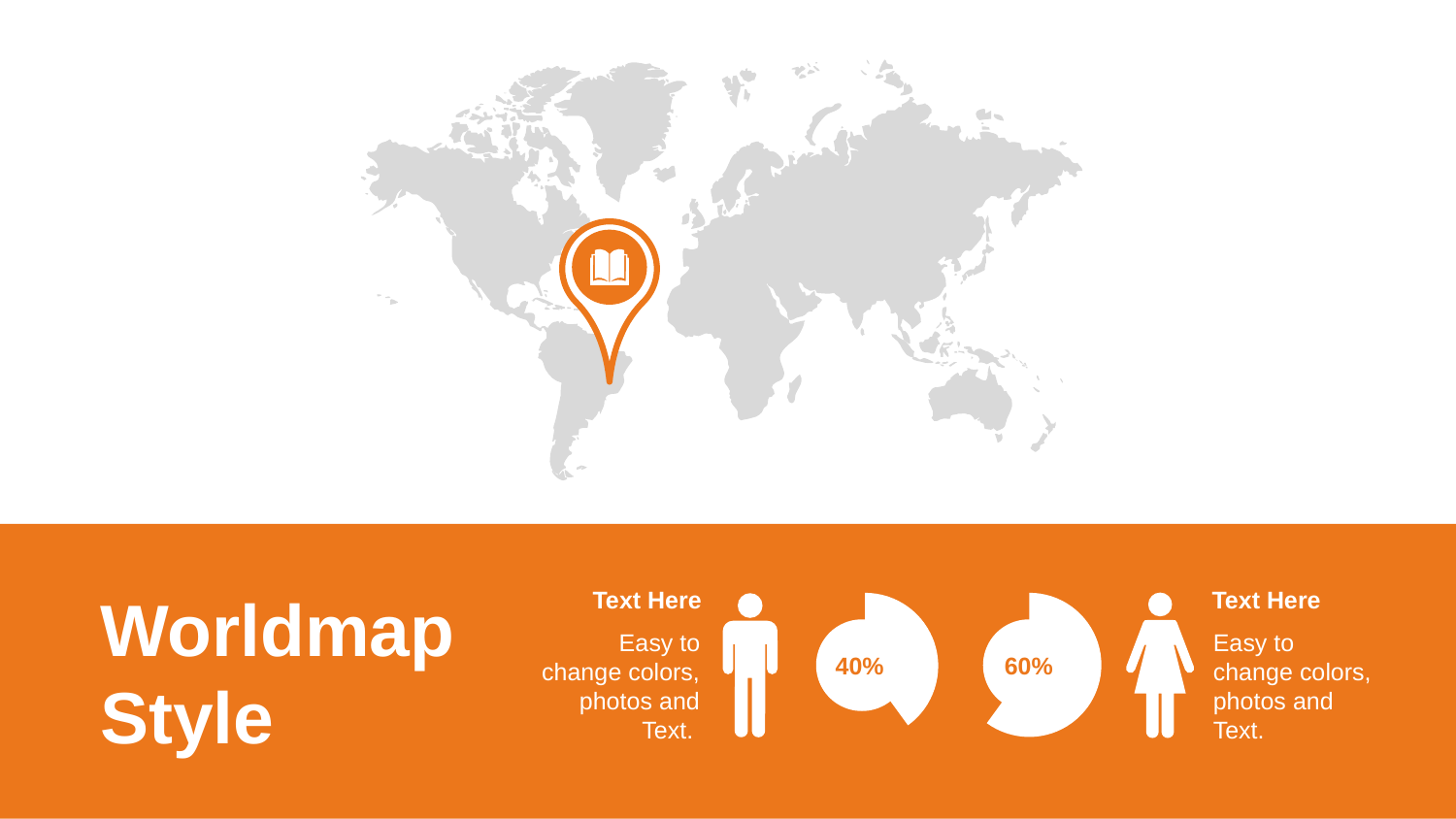
What is the difference between the percentage on the right pie chart and the percentage on the left pie chart? 20% What is the title of the slide containing the pie charts? Worldmap Style How many pie charts are shown on the slide? 2 Which pie chart shows the lowest percentage? The left one, next to the male figure What colour are the pie charts on the slide? White What kind of chart is used to display the 40% and 60% values? Doughnut chart What percentage is shown on the pie chart next to the male figure? 40% What percentage is shown on the pie chart next to the female figure? 60% Which pie chart shows the larger percentage, the one next to the male figure or the one next to the female figure? The one next to the female figure